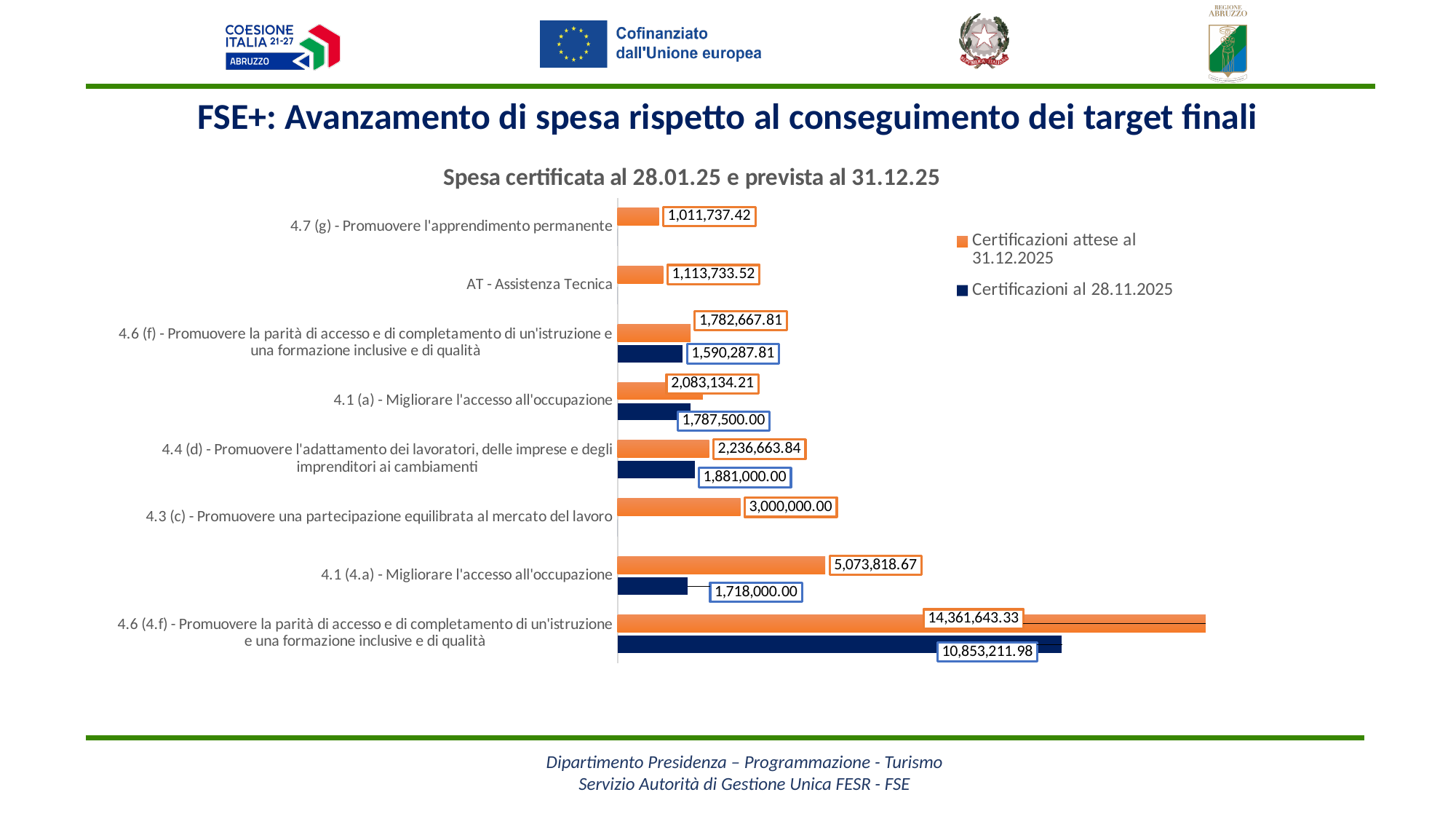
What is the title of the chart? Spesa certificata al 28.01.25 e prevista al 31.12.25 How many categories are shown on the chart? 8 What is the difference between 'Certificazioni attese al 31.12.2025' and 'Certificazioni al 28.11.2025' for '4.4 (d) - Promuovere l'adattamento dei lavoratori, delle imprese e degli imprenditori ai cambiamenti'? 355,663.84 What is the value of 'Certificazioni al 28.11.2025' for '4.1 (4.a) - Migliorare l'accesso all'occupazione'? 1,718,000.00 What type of chart is shown on the slide? Bar chart Which category has the highest value for 'Certificazioni attese al 31.12.2025'? 4.6 (4.f) - Promuovere la parità di accesso e di completamento di un'istruzione e una formazione inclusive e di qualità Which category has the lowest value for 'Certificazioni attese al 31.12.2025'? 4.7 (g) - Promuovere l'apprendimento permanente What is the difference between 'Certificazioni attese al 31.12.2025' and 'Certificazioni al 28.11.2025' for '4.6 (4.f) - Promuovere la parità di accesso e di completamento di un'istruzione e una formazione inclusive e di qualità'? 3,508,431.35 What is the value of 'Certificazioni attese al 31.12.2025' for '4.3 (c) - Promuovere una partecipazione equilibrata al mercato del lavoro'? 3,000,000.00 How many series does the chart legend list? 2 What is the value of 'Certificazioni attese al 31.12.2025' for 'AT - Assistenza Tecnica'? 1,113,733.52 Which is larger: 'Certificazioni al 28.11.2025' for '4.4 (d) - Promuovere l'adattamento dei lavoratori, delle imprese e degli imprenditori ai cambiamenti' or for '4.1 (a) - Migliorare l'accesso all'occupazione'? 4.4 (d) - Promuovere l'adattamento dei lavoratori, delle imprese e degli imprenditori ai cambiamenti